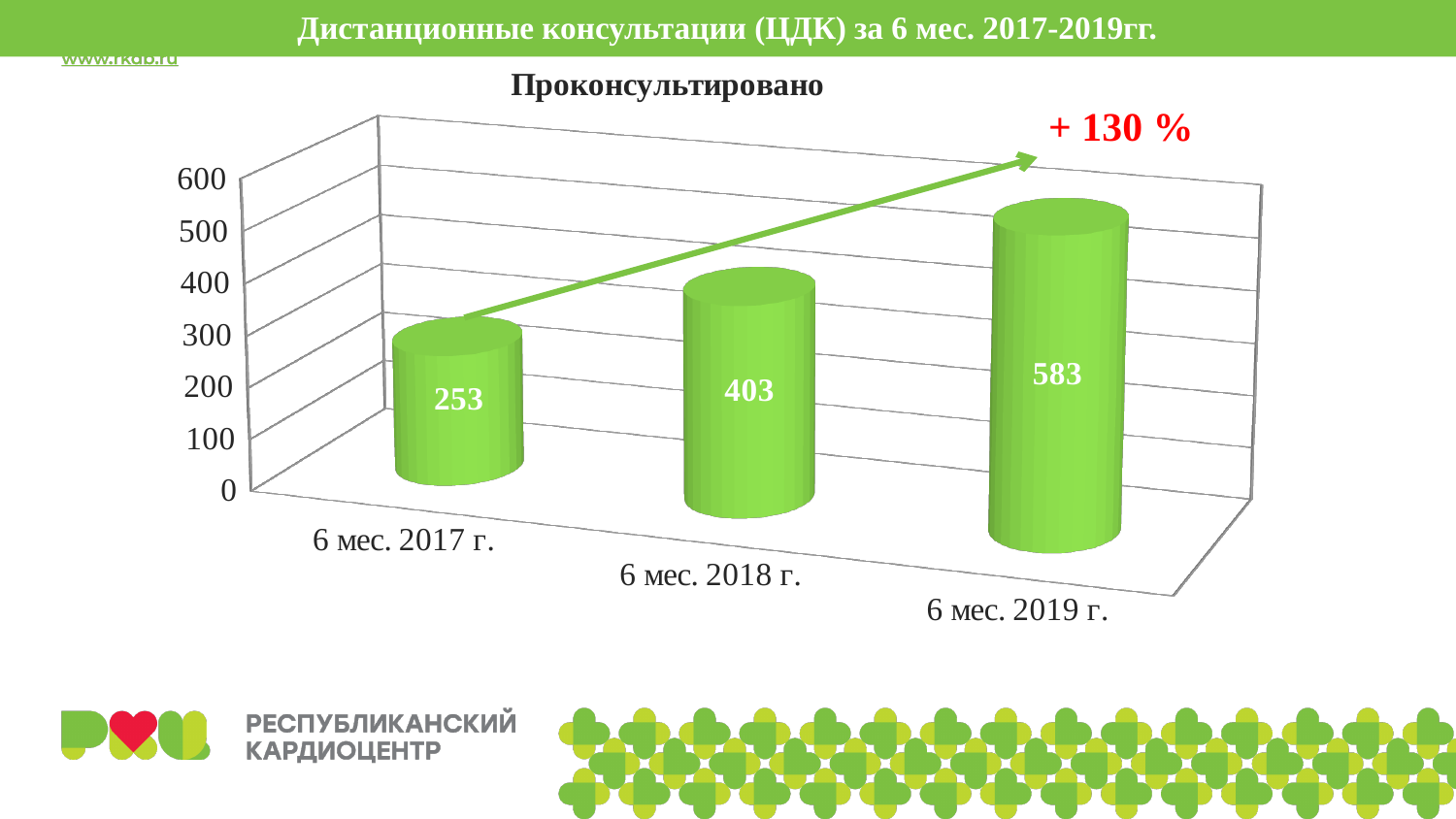
Which category has the lowest value? 6 мес. 2017 г. What is the difference between the values for 6 мес. 2019 г. and 6 мес. 2017 г.? 330 What is the value for 6 мес. 2018 г.? 403 Which is larger, the value for 6 мес. 2018 г. or 6 мес. 2019 г.? 6 мес. 2019 г. Which category has the highest value? 6 мес. 2019 г. How many categories are shown on the chart? 3 What is the value for 6 мес. 2017 г.? 253 What is the value for 6 мес. 2019 г.? 583 What is the difference between the values for 6 мес. 2018 г. and 6 мес. 2017 г.? 150 What kind of chart is shown on the slide? bar chart What is the title of the chart? Проконсультировано Do the values rise or fall from 6 мес. 2017 г. to 6 мес. 2019 г.? rise